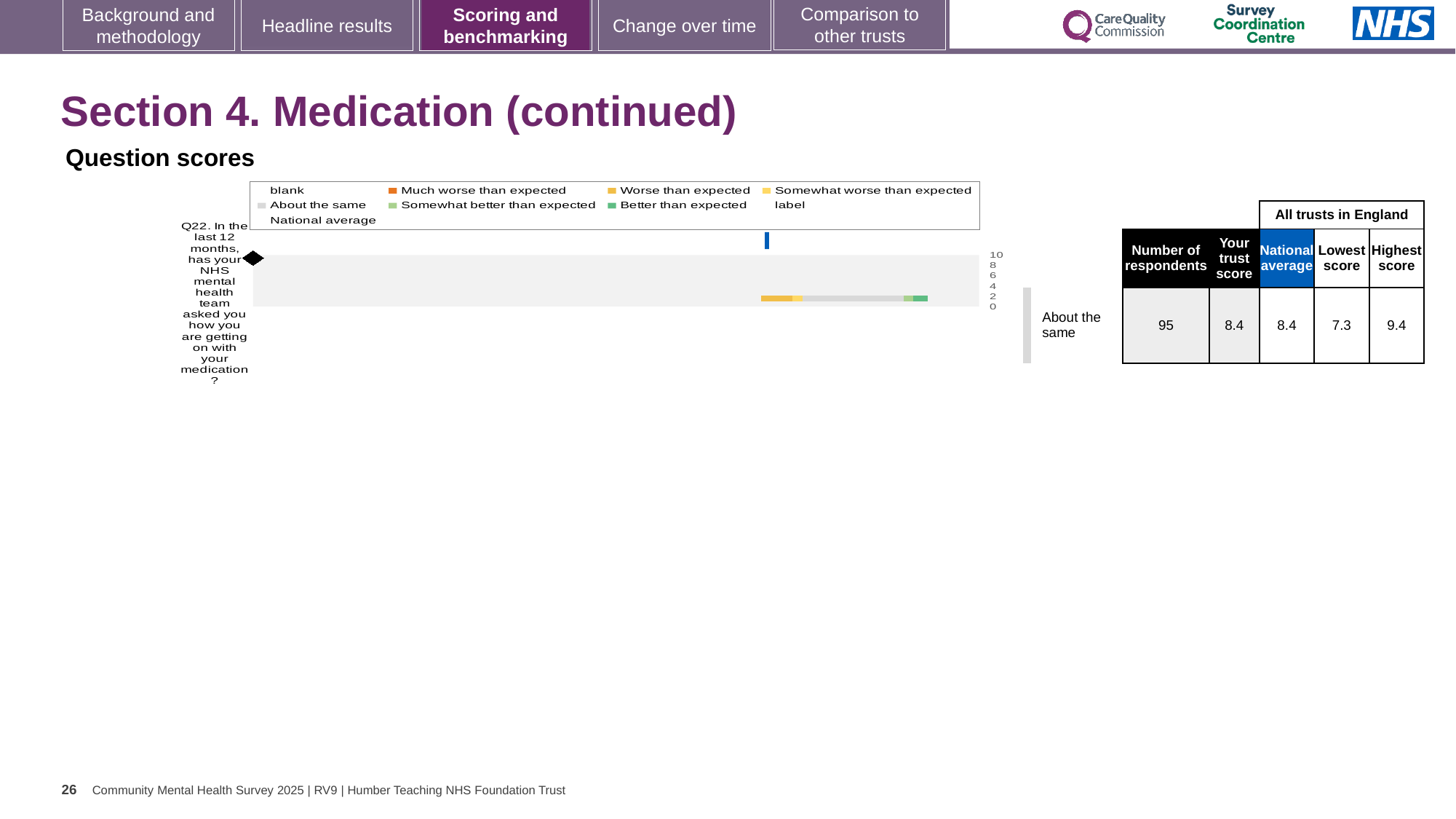
In the table next to the chart, what is the lowest score among all trusts in England for Q22? 7.3 Which question number is plotted in the chart? Q22 Is the trust score for Q22 larger than, smaller than, or equal to the national average? equal What is the difference between the highest score and the lowest score for Q22 in the table? 2.1 In the table next to the chart, what is the trust score for Q22? 8.4 What kind of chart is shown on the slide? bar chart In the table next to the chart, what is the national average for Q22? 8.4 In the table next to the chart, what is the number of respondents for Q22? 95 What benchmark rating is shown next to the chart for Q22? About the same In the table next to the chart, what is the highest score among all trusts in England for Q22? 9.4 How many questions (categories) are plotted in the chart? 1 Which legend entry is shown in orange? Much worse than expected